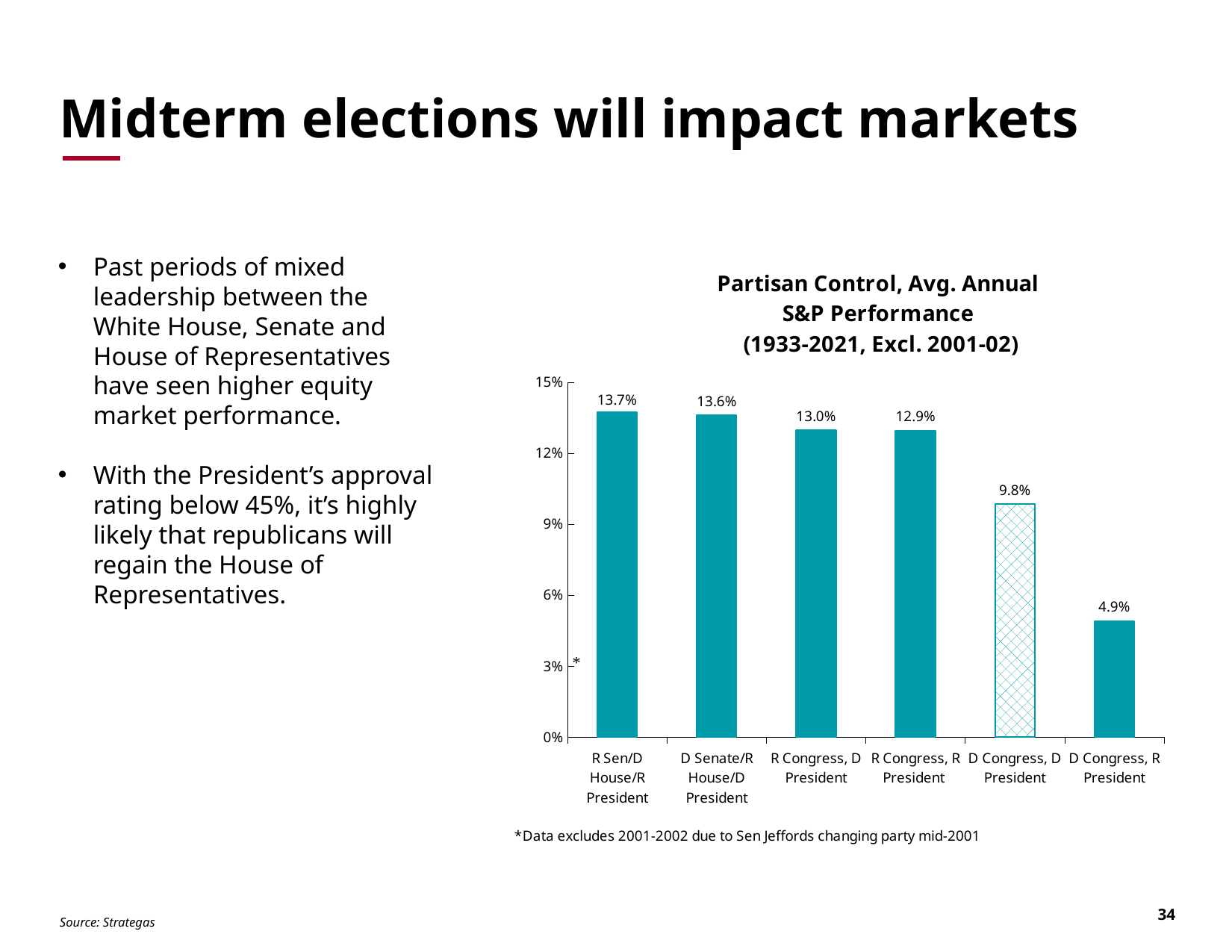
What is the value shown for D Congress, R President? 4.9% Is the value for D Congress, D President greater or less than 12%? less What is the average annual S&P performance for R Sen/D House/R President? 13.7% What is the value shown for D Congress, D President? 9.8% Which bar is drawn with a hatched pattern rather than solid fill? D Congress, D President Which is larger, the value for D Senate/R House/D President or the value for R Congress, R President? D Senate/R House/D President What is the difference between the values for R Congress, D President and D Congress, R President? 8.1% How many categories are shown on the chart? 6 Which category has the highest average annual S&P performance? R Sen/D House/R President What kind of chart is shown on the slide? Bar chart Which category has the lowest average annual S&P performance? D Congress, R President What is the title of the chart? Partisan Control, Avg. Annual S&P Performance (1933-2021, Excl. 2001-02)